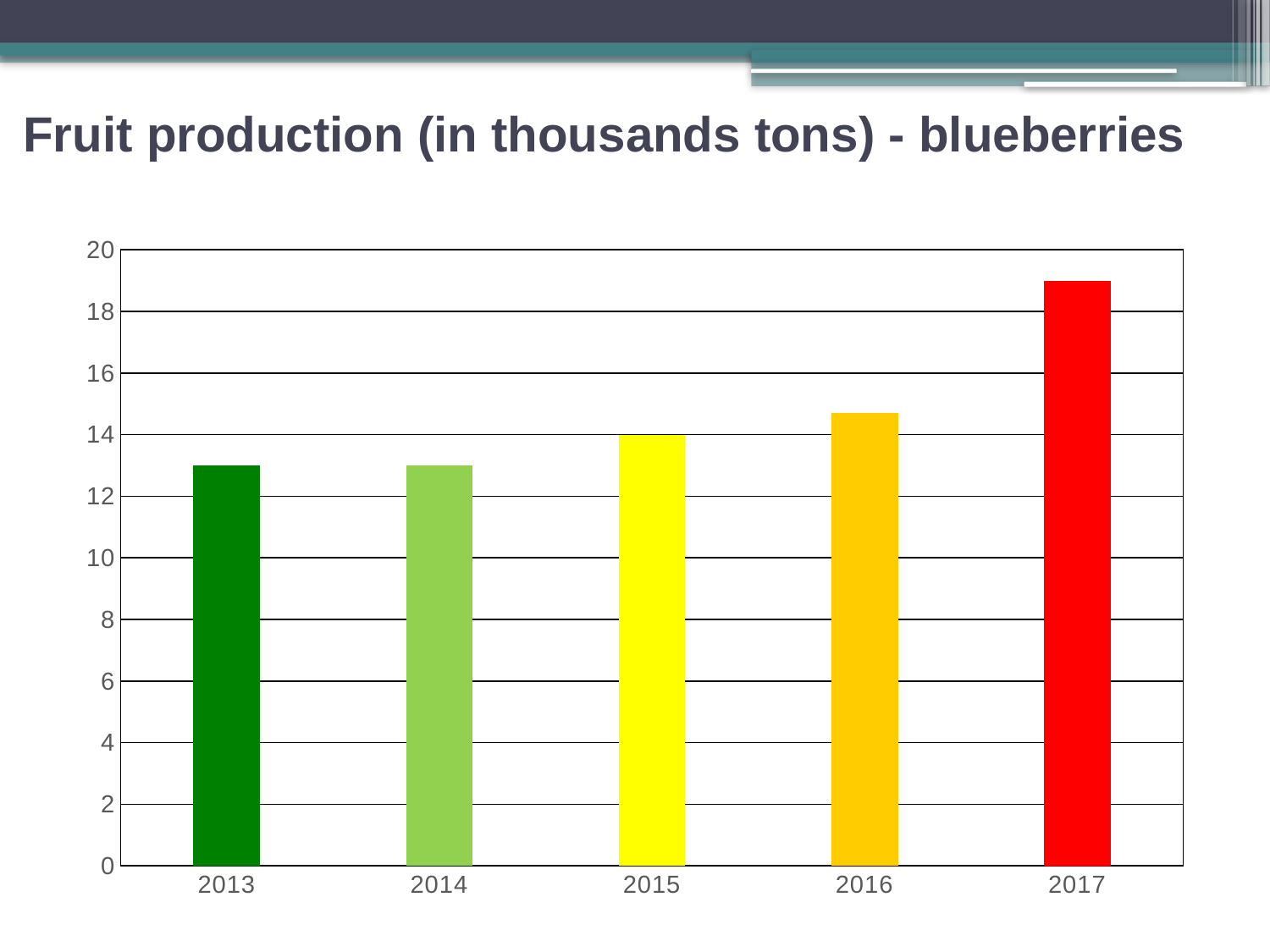
Is the value for 2016 greater or less than 16? less Is the value for 2017 greater or less than 18? greater Is the value for 2013 greater or less than 12? greater What is the title of the slide? Fruit production (in thousands tons) - blueberries What kind of chart is shown on the slide? bar chart Which is larger, the value for 2016 or the value for 2017? 2017 Which is larger, the value for 2013 or the value for 2015? 2015 What is the blueberry production value for 2015? 14 Do the values generally rise or fall from 2013 to 2017? rise Which year has the highest blueberry production? 2017 How many years are shown on the x axis of the chart? 5